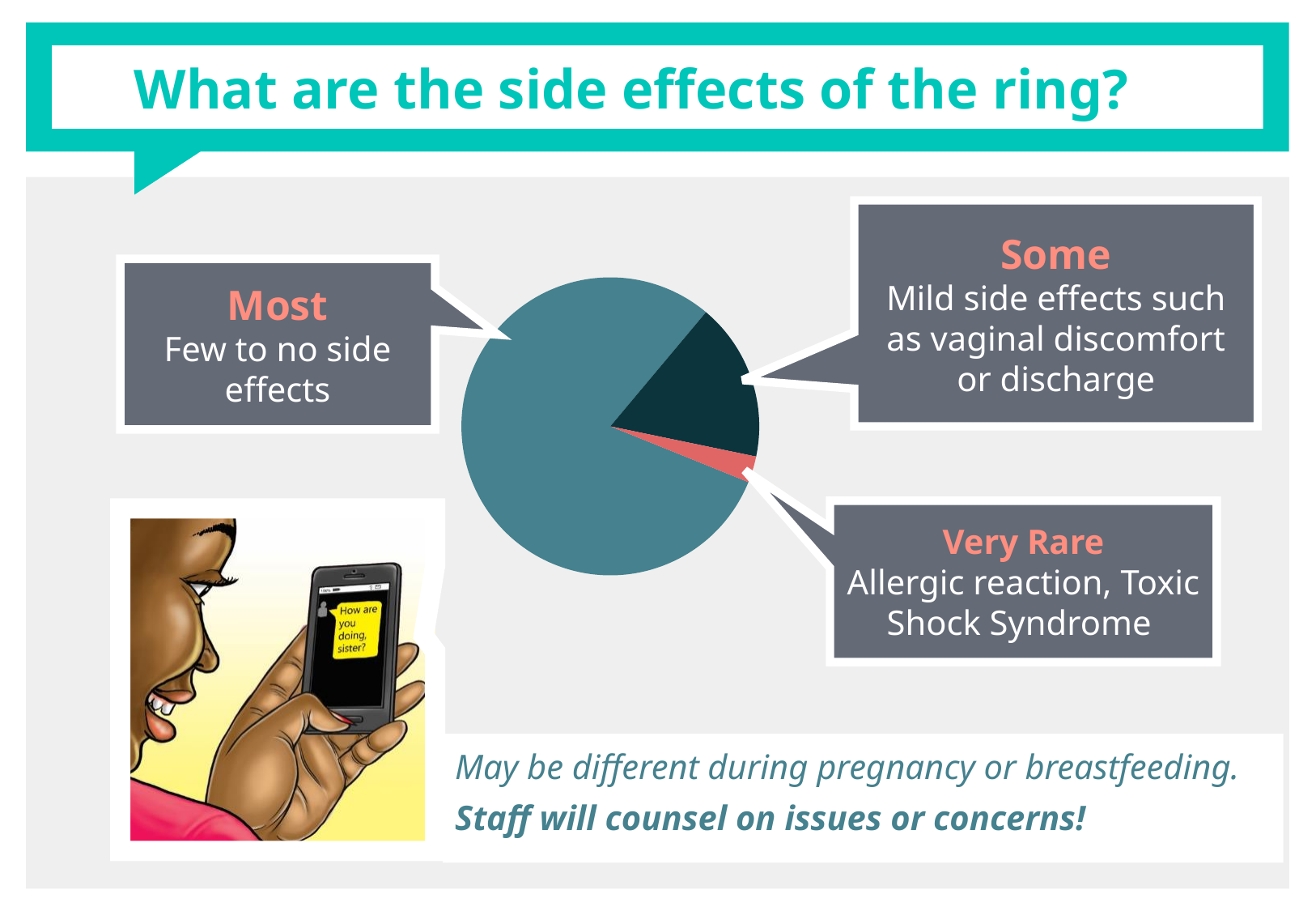
What is the title of the slide containing the pie chart? What are the side effects of the ring? Which slice of the pie chart is labelled "Mild side effects such as vaginal discomfort or discharge"? Some Which slice is larger: "Most" or "Some"? Most What side effects are listed for the "Very Rare" slice? Allergic reaction, Toxic Shock Syndrome Which slice of the pie chart is the largest? Most (Few to no side effects) What colour is the "Very Rare" slice of the pie chart? Red/pink What kind of chart is shown on the slide? Pie chart Which slice of the pie chart is the smallest? Very Rare (Allergic reaction, Toxic Shock Syndrome) Does the "Most" slice take up more or less than half of the pie? More Which slice is larger: "Some" or "Very Rare"? Some How many slices does the pie chart have? 3